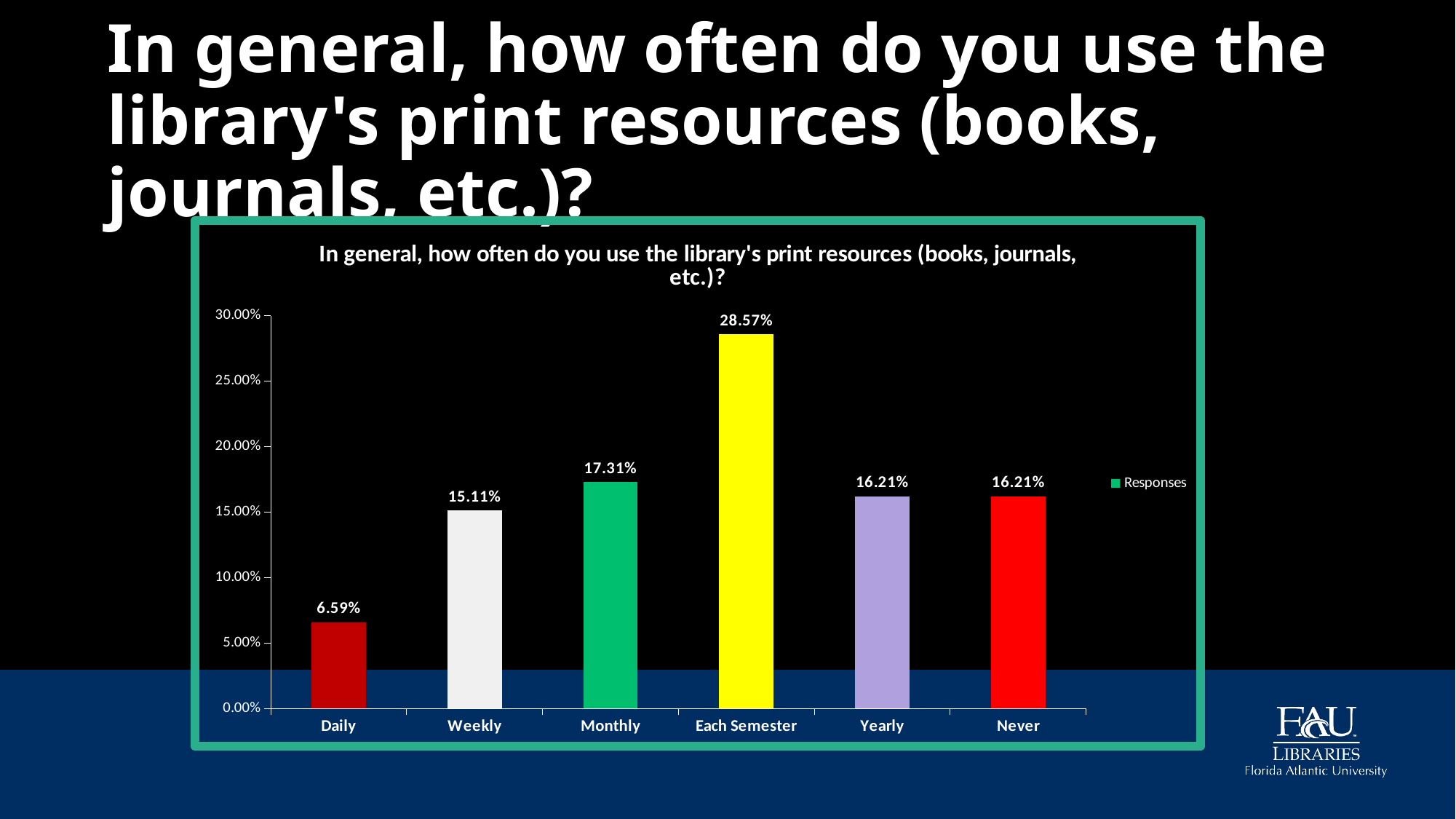
What is the value for Weekly? 15.11% What is the value for Daily? 6.59% What is the value for Monthly? 17.31% How many series does the legend list? 1 What kind of chart is shown? bar chart How many categories are shown on the x axis? 6 Is the value for Yearly greater or less than 20.00%? less Which category has the lowest value? Daily Which category has the highest value? Each Semester What is the value for Each Semester? 28.57% What is the difference between the values for Each Semester and Daily? 21.98% Which is larger, the value for Monthly or the value for Weekly? Monthly